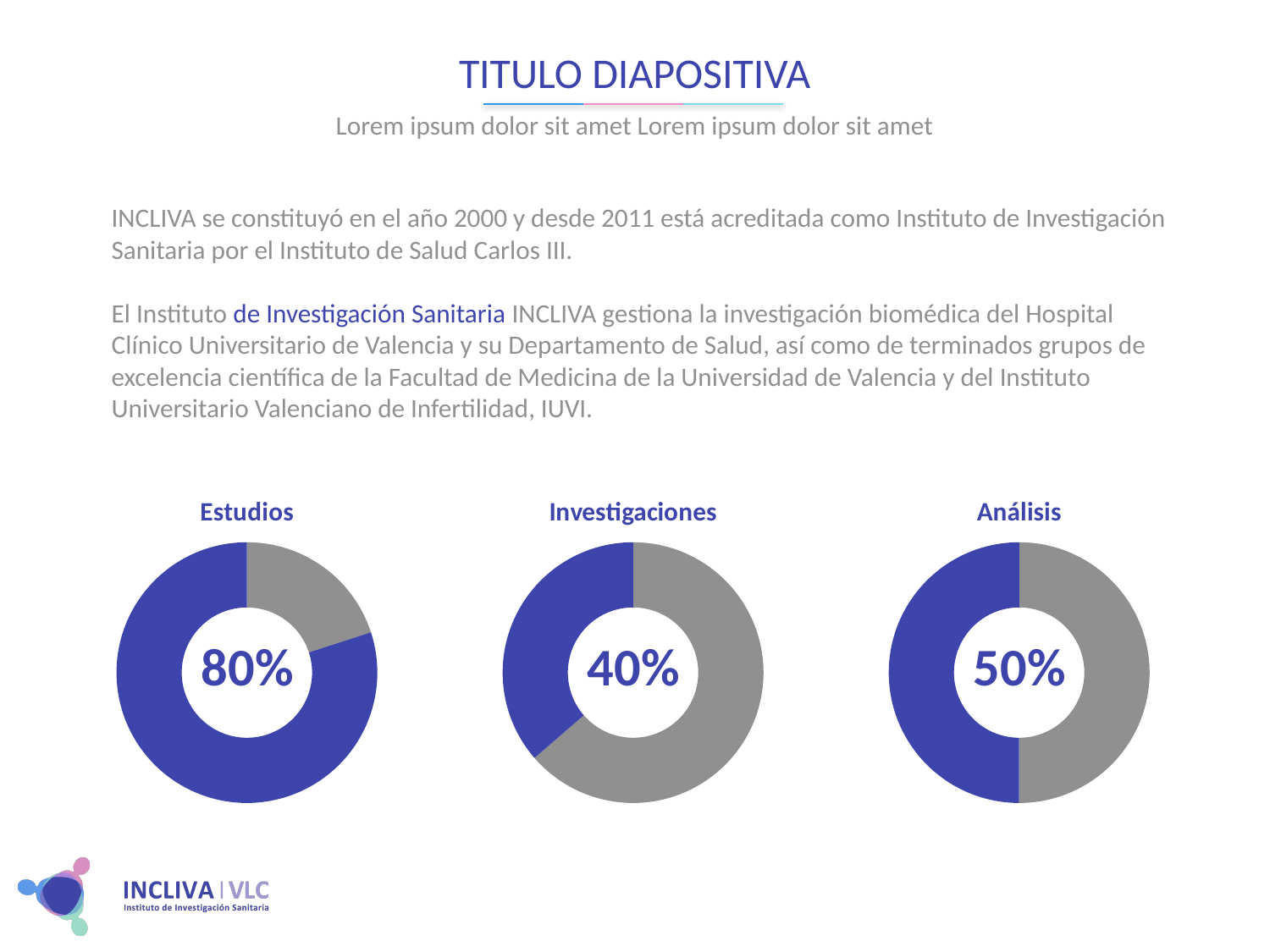
What colour is the filled (highlighted) portion of each doughnut chart? Blue What type of chart is used for Estudios, Investigaciones and Análisis? Doughnut chart What is the difference between the percentage in the Análisis chart and the percentage in the Investigaciones chart? 10% Which of the three charts (Estudios, Investigaciones, Análisis) shows the lowest percentage? Investigaciones Which of the three charts (Estudios, Investigaciones, Análisis) shows the highest percentage? Estudios What percentage is shown in the centre of the Investigaciones chart? 40% In the Análisis chart, what share of the ring is filled in blue? 50% What percentage is shown in the centre of the Estudios chart? 80% How many doughnut charts are shown on the slide? 3 Which is larger, the percentage in the Análisis chart or the percentage in the Investigaciones chart? Análisis What is the difference between the percentage in the Estudios chart and the percentage in the Investigaciones chart? 40% What percentage is shown in the centre of the Análisis chart? 50%